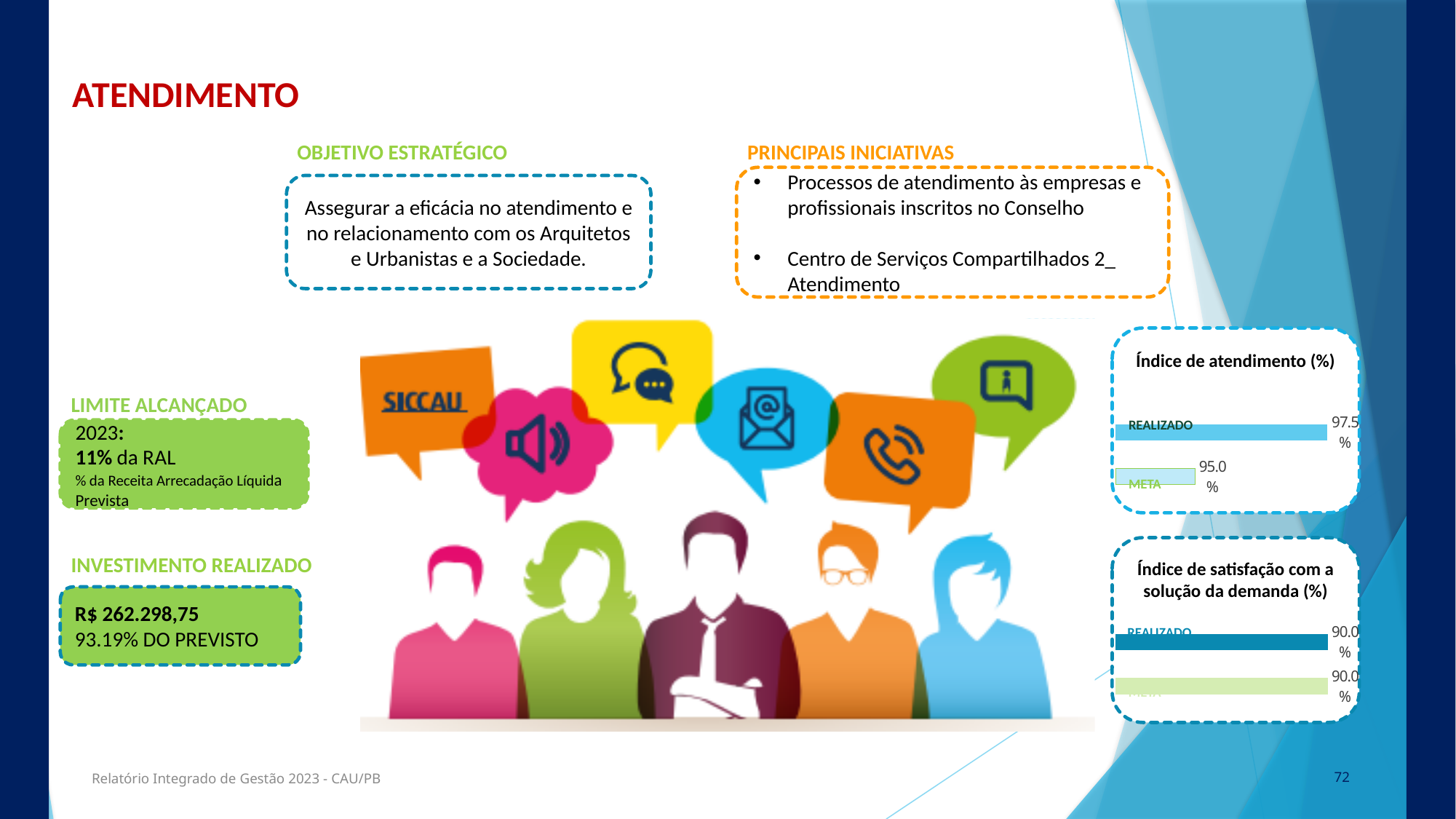
What is the title of the upper chart on the right side of the slide? Índice de atendimento (%) In the 'Índice de atendimento (%)' chart, what is the value for REALIZADO? 97.5% In the 'Índice de satisfação com a solução da demanda (%)' chart, what is the value for REALIZADO? 90.0% In the 'Índice de atendimento (%)' chart, what is the value for META? 95.0% In the 'Índice de atendimento (%)' chart, what is the difference between REALIZADO and META? 2.5% In the 'Índice de atendimento (%)' chart, is REALIZADO larger or smaller than META? larger How many charts are shown on the slide? 2 In the 'Índice de atendimento (%)' chart, which category has the higher value? REALIZADO In the 'Índice de satisfação com a solução da demanda (%)' chart, what is the difference between REALIZADO and META? 0.0% In the 'Índice de satisfação com a solução da demanda (%)' chart, what is the value for META? 90.0% How many bars does the 'Índice de atendimento (%)' chart show? 2 What kind of chart is the 'Índice de satisfação com a solução da demanda (%)' chart? bar chart